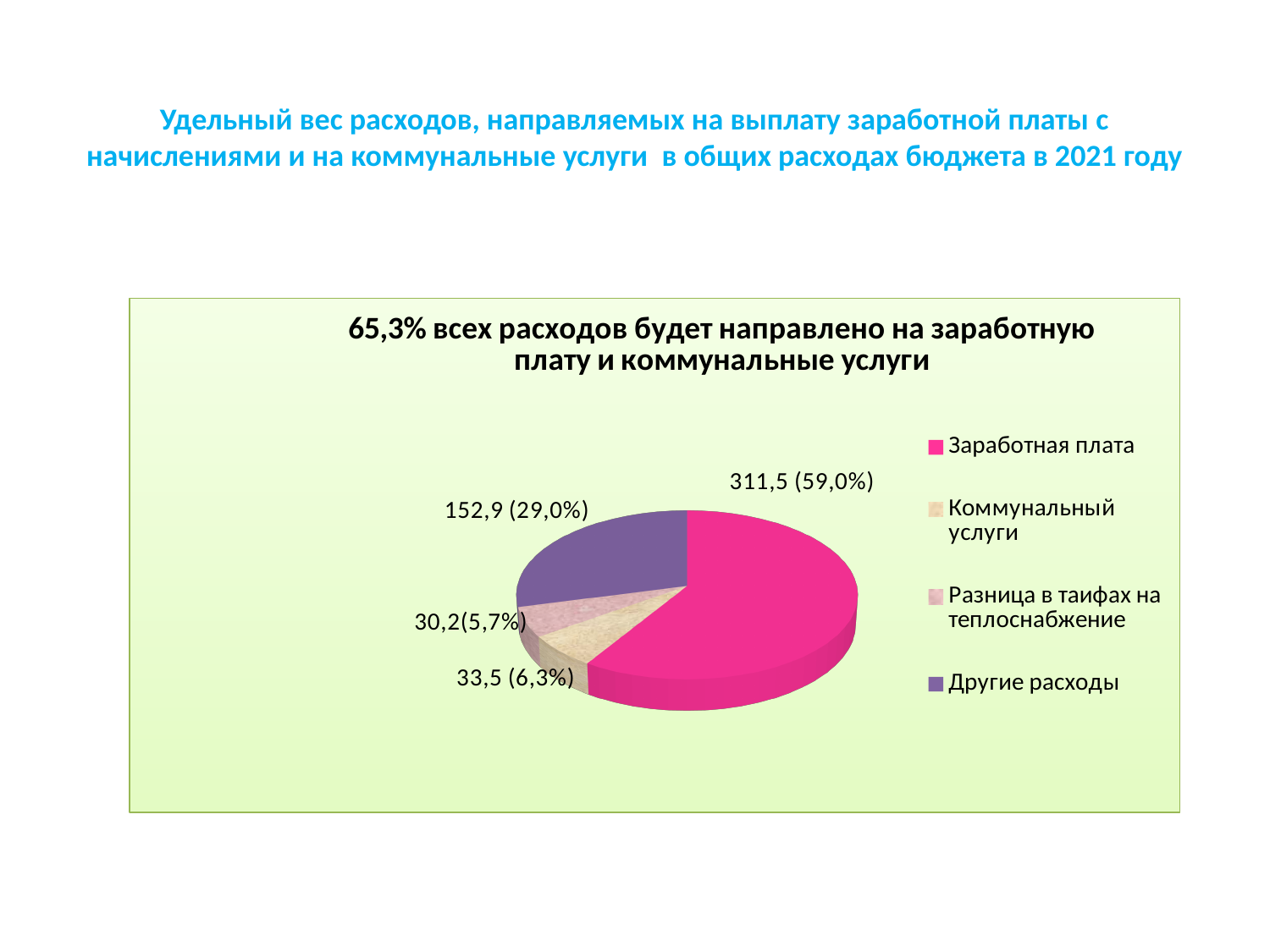
How many entries does the legend of the pie chart list? 4 Which slice of the pie chart is the smallest? Разница в таифах на теплоснабжение Which is larger, the slice for "Заработная плата" or the slice for "Другие расходы"? Заработная плата Which slice of the pie chart is the largest? Заработная плата What share of the pie does "Другие расходы" take? 29,0% What value is shown for the slice "Другие расходы"? 152,9 (29,0%) How many slices does the pie chart have? 4 What value is shown for the slice "Разница в таифах на теплоснабжение"? 30,2(5,7%) What value is shown for the slice "Коммунальные услуги"? 33,5 (6,3%) What kind of chart is shown on the slide? Pie chart What is the title of the pie chart? 65,3% всех расходов будет направлено на заработную плату и коммунальные услуги What value is shown for the slice "Заработная плата"? 311,5 (59,0%)